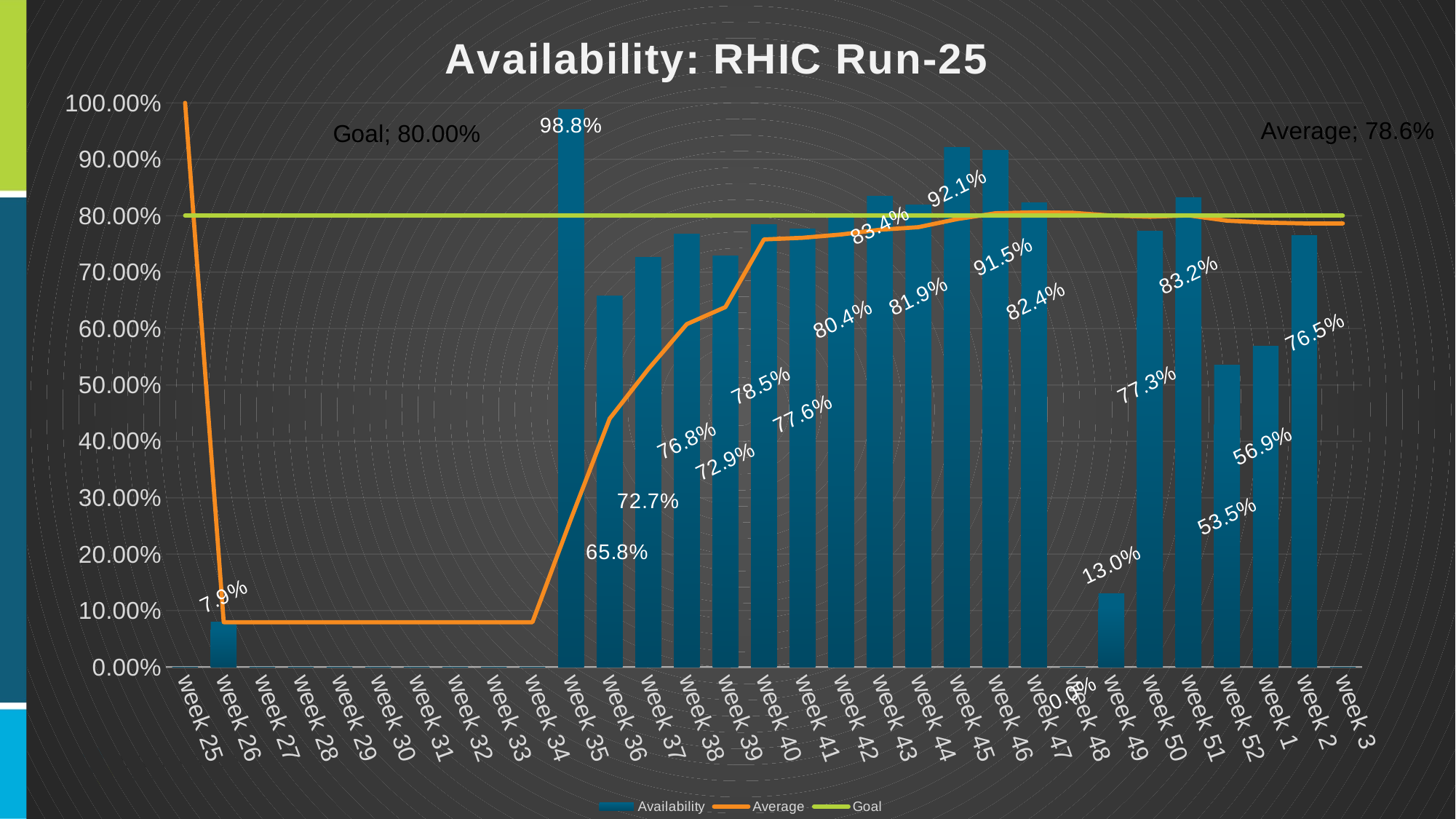
Which has the higher availability, week 52 or week 1? week 1 What is the availability value for week 26? 7.9% What is the availability value for week 49? 13.0% Which week has the highest availability? week 35 What is the difference between the availability for week 45 and week 46? 0.6% What is the availability value for week 45? 92.1% What is the difference between the availability for week 35 and week 26? 90.9% Is the availability for week 36 greater or less than 70.00%? less How many series does the legend list? 3 What is the Goal value shown on the chart? 80.00% What kind of chart is used to show the Availability series? bar chart What is the availability value for week 35? 98.8%